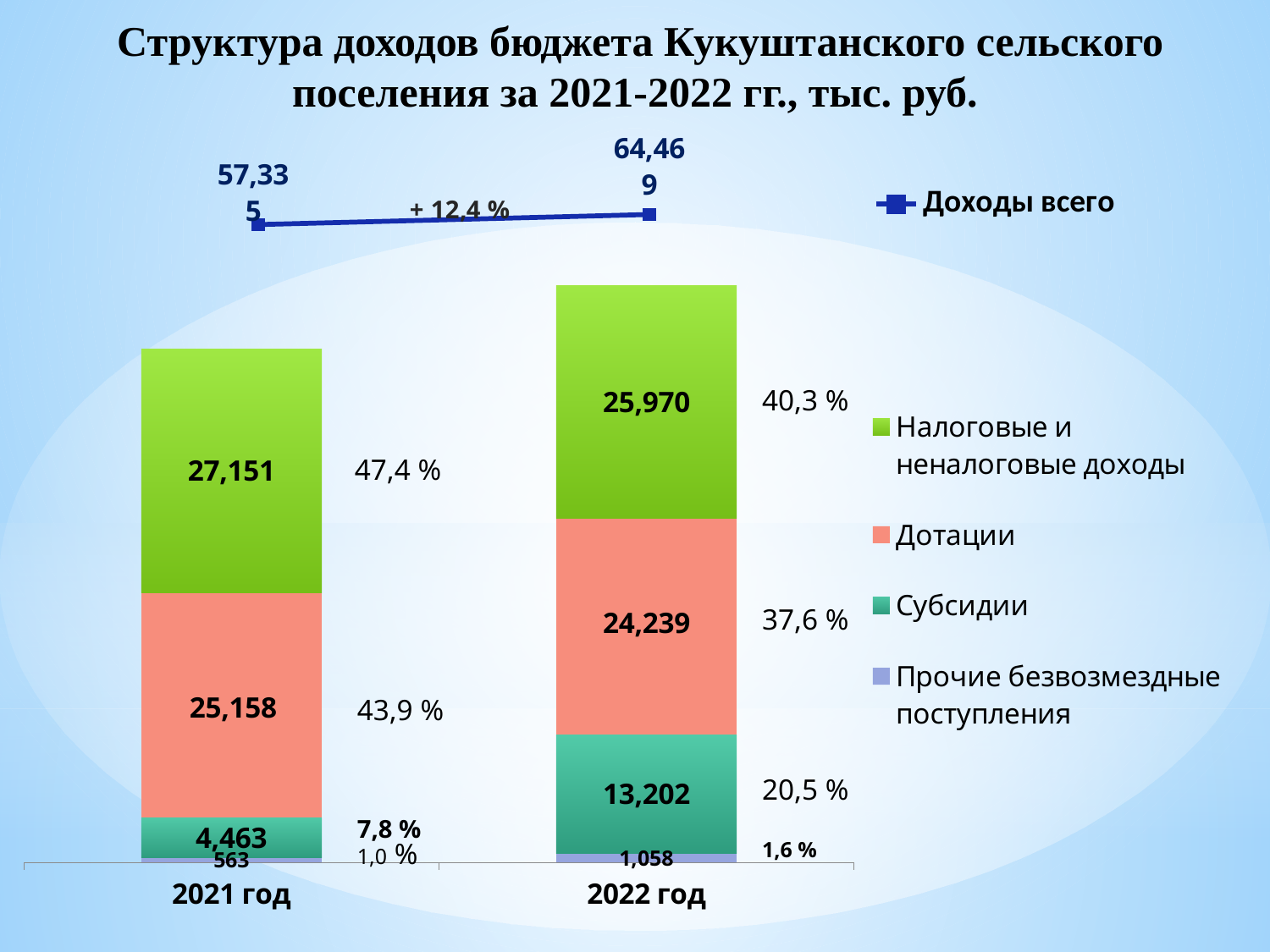
What kind of chart is shown on the slide? Stacked bar chart with a line What is the difference between the Субсидии values for 2022 год and 2021 год? 8,739 What is the value of Прочие безвозмездные поступления for 2021 год? 563 What is the value of Налоговые и неналоговые доходы for 2021 год? 27,151 What percentage change in total income is labelled on the line between 2021 and 2022? + 12,4 % What percentage share is shown for Дотации in 2021 год? 43,9 % What is the value of Субсидии for 2022 год? 13,202 Which year has the larger value for Налоговые и неналоговые доходы, 2021 год or 2022 год? 2021 год What is the total Доходы всего value shown for 2022 год? 64,469 Which series has the smallest value in 2022 год? Прочие безвозмездные поступления How many year categories are shown on the x axis? 2 What is the value of Дотации for 2022 год? 24,239